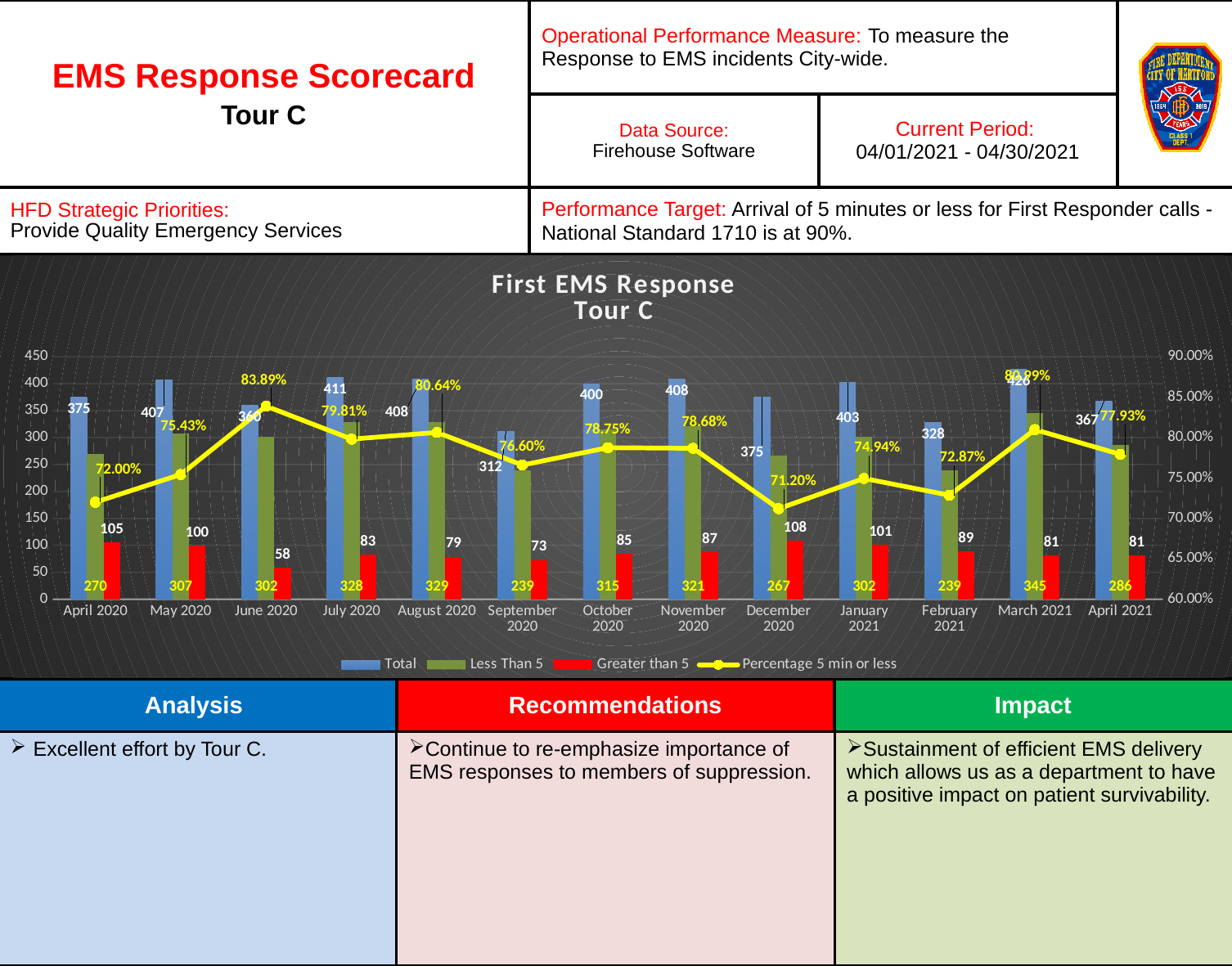
Which month has the lowest Greater than 5 value? June 2020 What type of chart is shown on the slide? Combination bar and line chart What is the difference between the Total values for July 2020 and September 2020? 99 What is the Greater than 5 value for December 2020? 108 What is the Total value for July 2020? 411 What is the Less Than 5 value for August 2020? 329 Which month has the lowest Percentage 5 min or less value? December 2020 Which month has the lowest Total value? September 2020 How many months are shown on the x axis of the chart? 13 What is the Percentage 5 min or less value for June 2020? 83.89% Which is larger, the Total value for May 2020 or the Total value for January 2021? May 2020 How many series does the chart legend list? 4